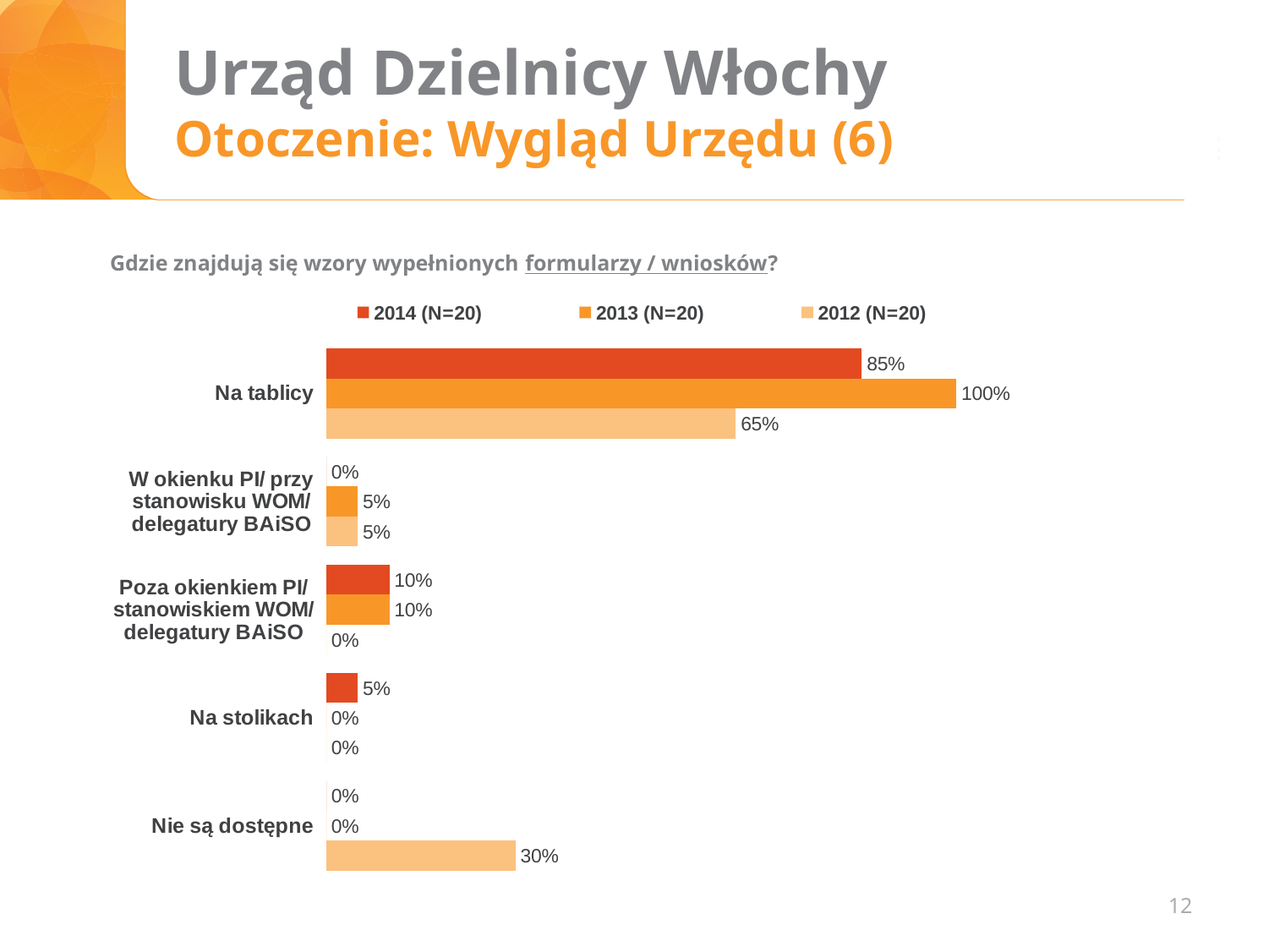
How many series does the legend list? 3 What is the difference between the 2013 (N=20) and 2012 (N=20) values for "Na tablicy"? 35% Which category has the highest value in the 2014 (N=20) series? Na tablicy What is the value for "Nie są dostępne" in the 2012 (N=20) series? 30% What is the value for "Na stolikach" in the 2014 (N=20) series? 5% What question does the chart answer, as written above it? Gdzie znajdują się wzory wypełnionych formularzy / wniosków? Which is larger for "Na tablicy": the 2014 (N=20) value or the 2012 (N=20) value? 2014 (N=20) What is the difference between the 2013 (N=20) and 2014 (N=20) values for "Na tablicy"? 15% What is the value for "Na tablicy" in the 2013 (N=20) series? 100% What kind of chart is shown on the slide? Bar chart What is the value for "Na tablicy" in the 2012 (N=20) series? 65% How many categories are shown on the chart? 5